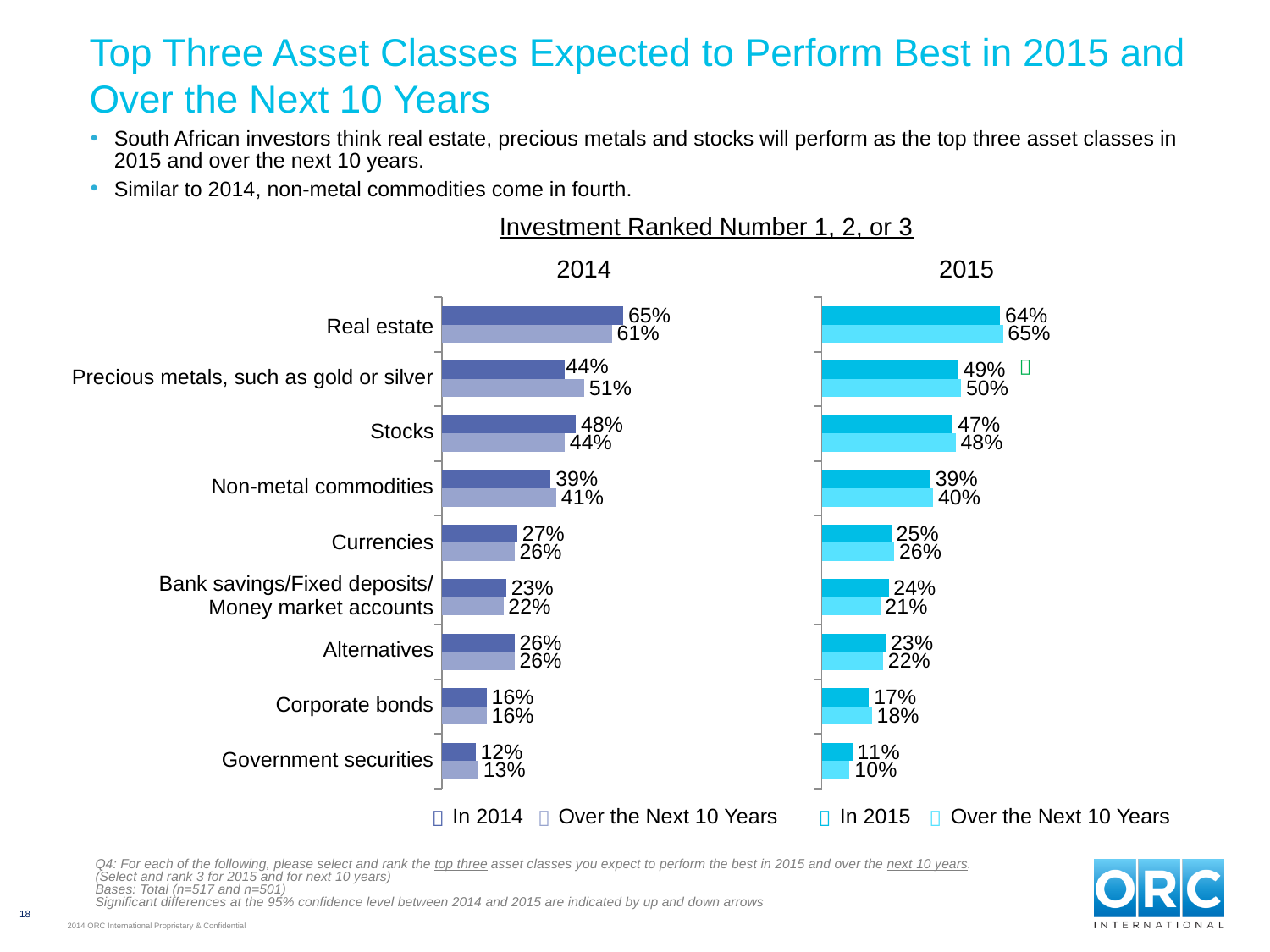
In the 2015 chart, what is the difference between the 'In 2015' values for Real estate and Stocks? 17% What is the shared title above the two charts? Investment Ranked Number 1, 2, or 3 What type of chart is the 2015 chart? Bar chart How many series does the legend of the 2014 chart list? 2 In the 2014 chart, which category has the lowest 'In 2014' value? Government securities In the 2014 chart, which is larger for Stocks: the 'In 2014' value or the 'Over the Next 10 Years' value? In 2014 How many categories are shown in the 2015 chart? 9 In the 2015 chart, which category has the highest 'In 2015' value? Real estate In the 2015 chart, what is the 'Over the Next 10 Years' value for Precious metals, such as gold or silver? 50% In the 2014 chart, what is the difference between the 'Over the Next 10 Years' and 'In 2014' values for Precious metals, such as gold or silver? 7% In the 2015 chart, what is the 'In 2015' value for Bank savings/Fixed deposits/Money market accounts? 24% In the 2014 chart, what is the 'In 2014' value for Real estate? 65%